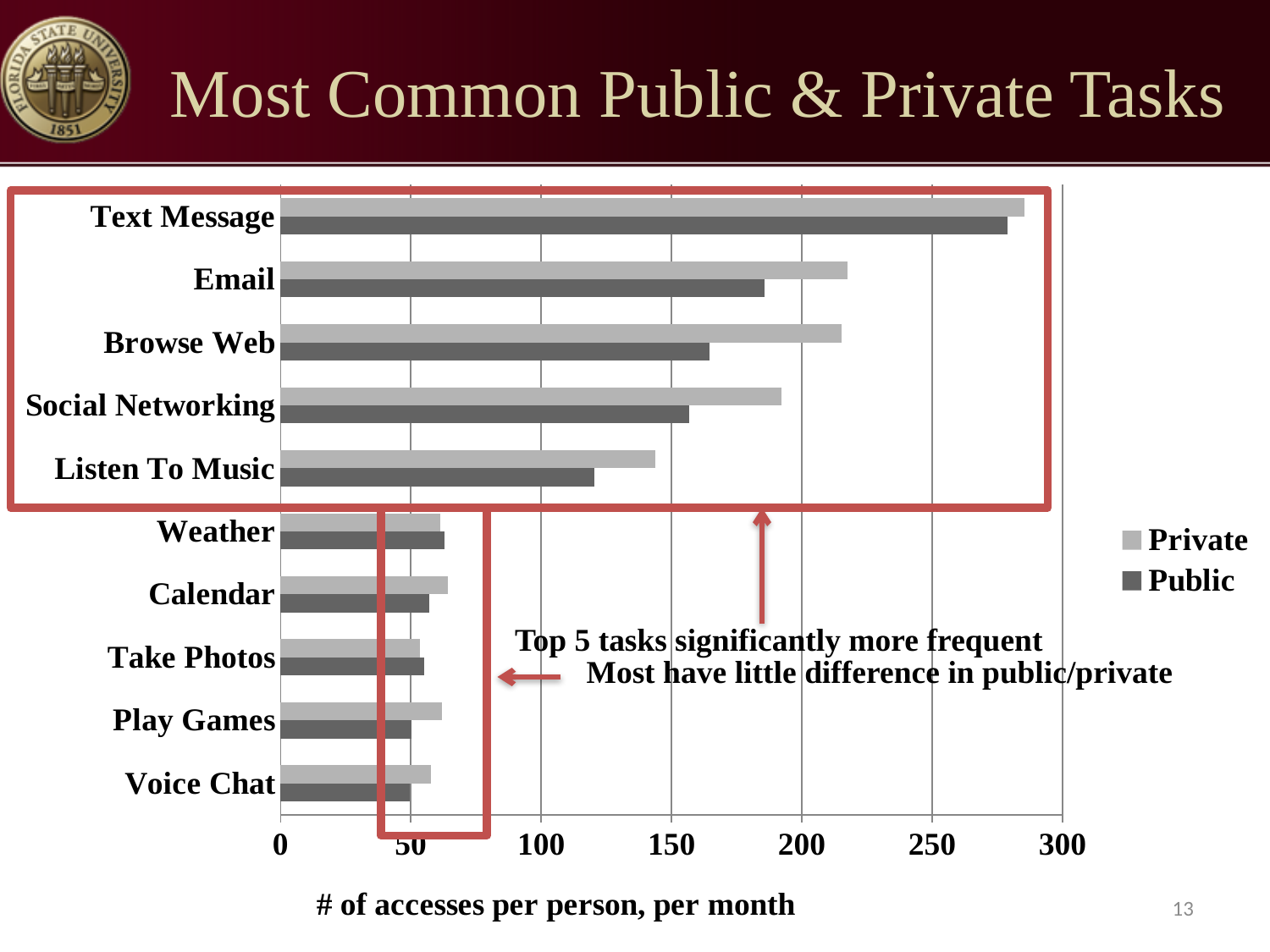
Which is larger for Listen To Music, the Private value or the Public value? Private Is the Private value for Weather greater or less than 100? less Is the Private value for Text Message greater or less than 250? greater Is the Public value for Email greater or less than 150? greater Which task has the highest Private value? Text Message What kind of chart is shown on the slide? bar chart Which has the larger Public value, Email or Browse Web? Email How many tasks (categories) are plotted on the chart? 10 What is the label on the horizontal axis of the chart? # of accesses per person, per month Which task has the highest Public value? Text Message How many series does the legend list? 2